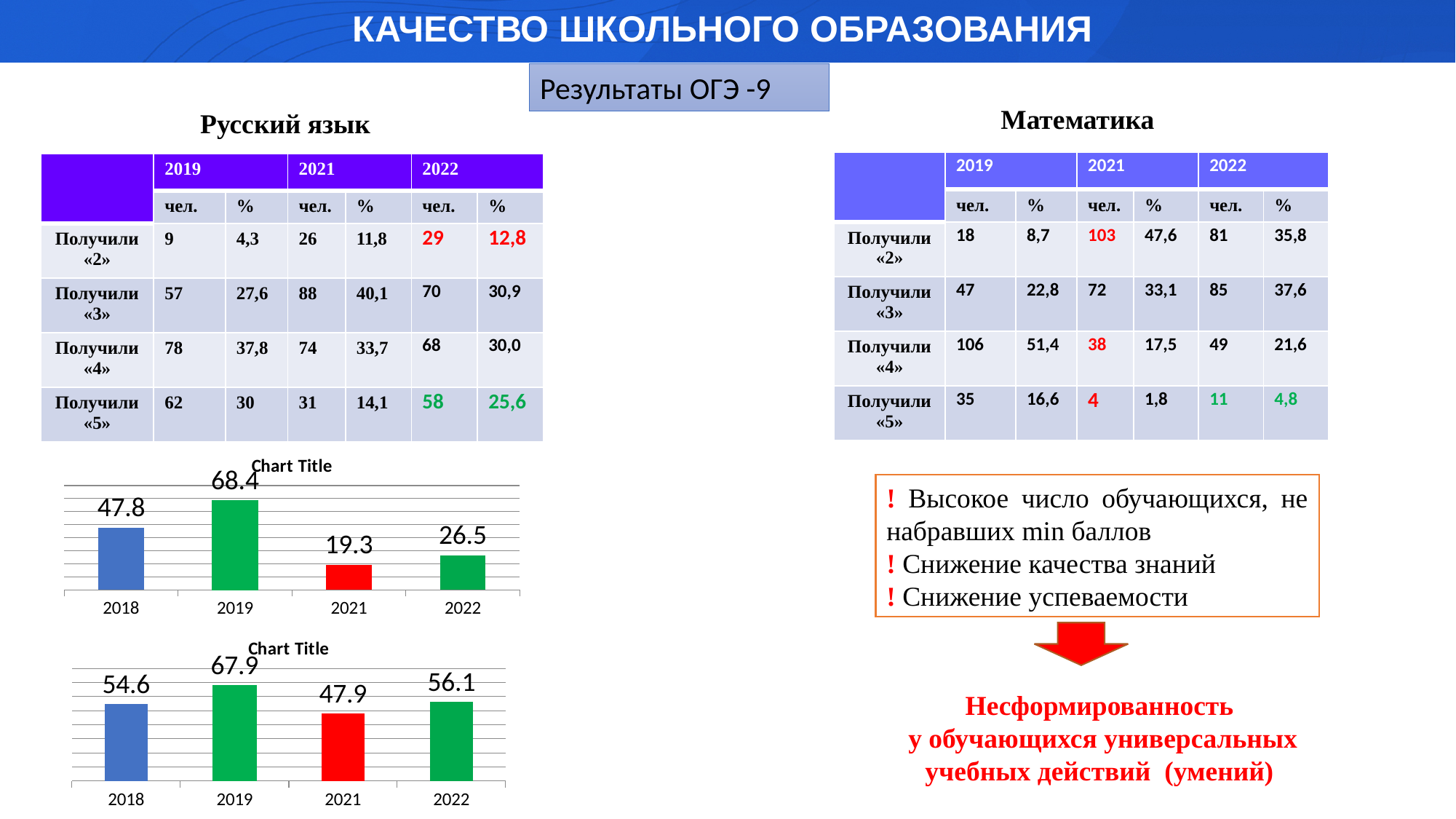
In the upper bar chart, which year has the lowest value? 2021 In the upper bar chart, what is the difference between the values for 2019 and 2021? 49.1 In the lower bar chart, what is the difference between the values for 2019 and 2018? 13.3 In the lower bar chart, what is the value for 2022? 56.1 In the upper bar chart, which year has the highest value? 2019 What type of chart is the lower chart on the slide? Bar chart In the upper bar chart, what is the value for 2019? 68.4 In the lower bar chart, what is the value for 2018? 54.6 In the lower bar chart, which year has the lowest value? 2021 In the lower bar chart, which is larger, the value for 2022 or the value for 2018? 2022 How many bars are in the upper bar chart? 4 In the upper bar chart, what is the value for 2021? 19.3